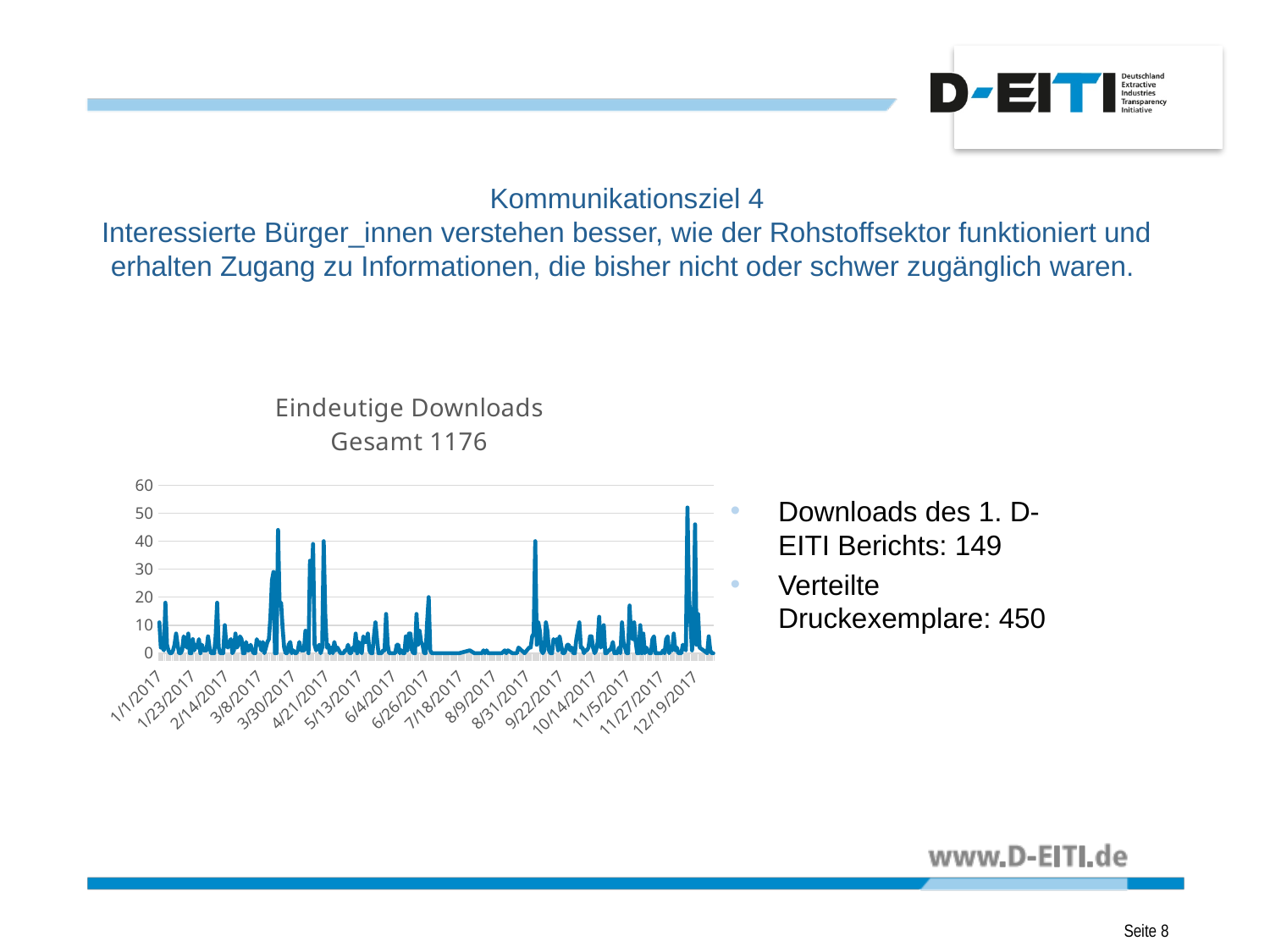
What is the highest tick value shown on the y axis of the chart? 60 Is the value around 7/18/2017 greater or less than 10? less In which month of 2017 does the highest daily download value occur? December Is the peak near 8/31/2017 greater or less than 30? greater What is the title of the chart? Eindeutige Downloads Gesamt 1176 Which is larger: the peak near 3/30/2017 or the highest peak in December 2017? the December 2017 peak What kind of chart is shown on the slide? line chart What total number of unique downloads (Gesamt) is stated in the chart title? 1176 Is the peak near 3/30/2017 greater or less than 40? greater How many data series are plotted in the chart? 1 How many date labels are shown along the x axis of the chart? 17